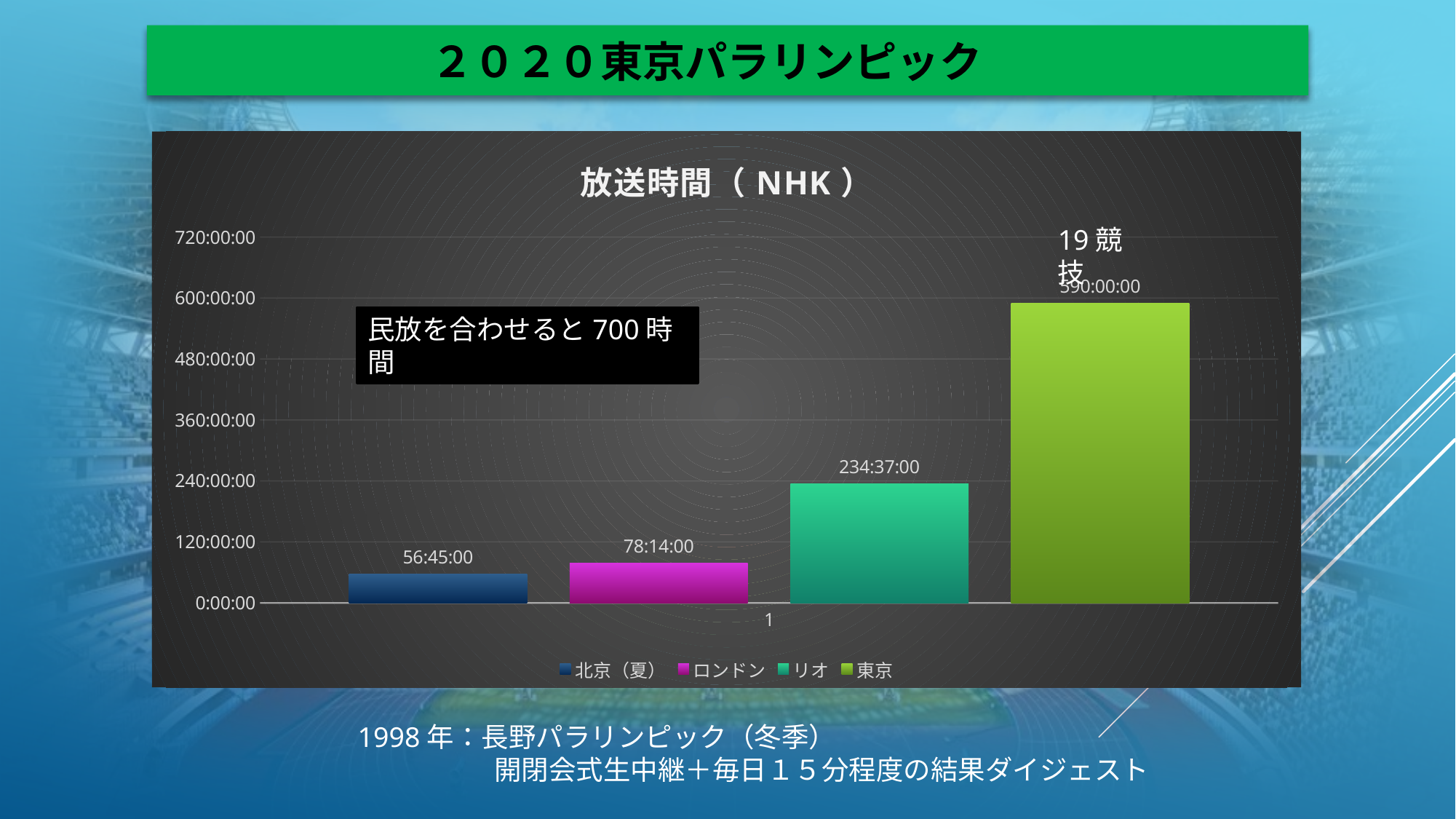
What is the value for ロンドン? 78:14:00 Which is larger, the value for ロンドン or the value for リオ? リオ What is the value for 北京（夏）? 56:45:00 What is the title of the chart? 放送時間（ＮＨＫ） What type of chart is shown on the slide? bar chart Which series has the lowest value? 北京（夏） What is the difference between the values for ロンドン and 北京（夏）? 21:29:00 Is the value for 東京 greater or less than 480:00:00? greater How many series does the legend list? 4 What is the value for リオ? 234:37:00 Is the value for リオ greater or less than 240:00:00? less Which series has the highest value? 東京